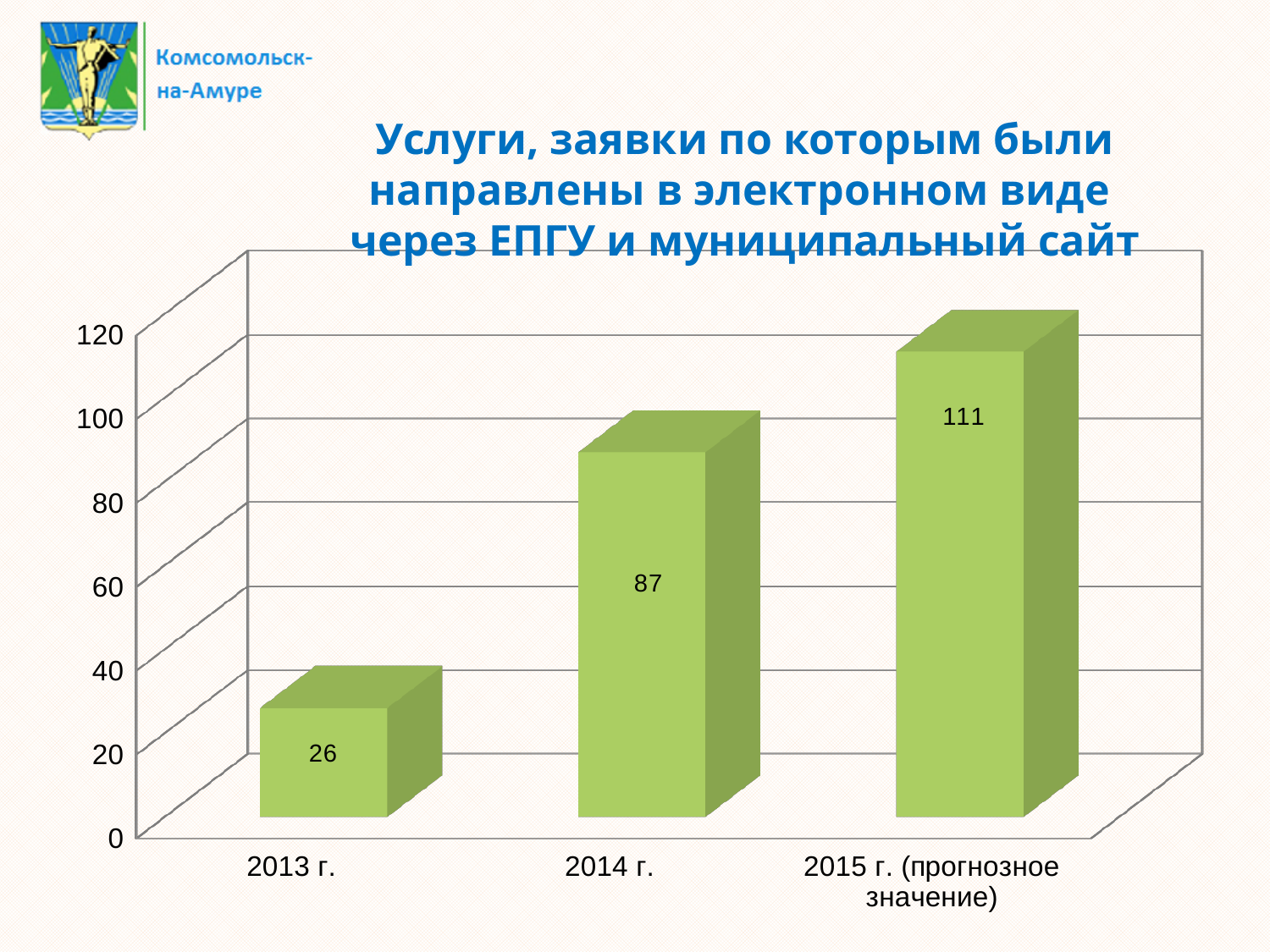
How many categories are shown on the x axis? 3 What is the difference between the values for 2014 г. and 2013 г.? 61 Is the value for 2014 г. greater or less than 100? less What is the difference between the values for 2015 г. (прогнозное значение) and 2014 г.? 24 Which is larger, the value for 2013 г. or the value for 2014 г.? 2014 г. Which category has the highest value? 2015 г. (прогнозное значение) What is the value for 2013 г.? 26 Which category has the lowest value? 2013 г. Do the values rise or fall from 2013 г. to 2015 г.? rise What is the value for 2015 г. (прогнозное значение)? 111 What kind of chart is shown on the slide? bar chart What is the value for 2014 г.? 87